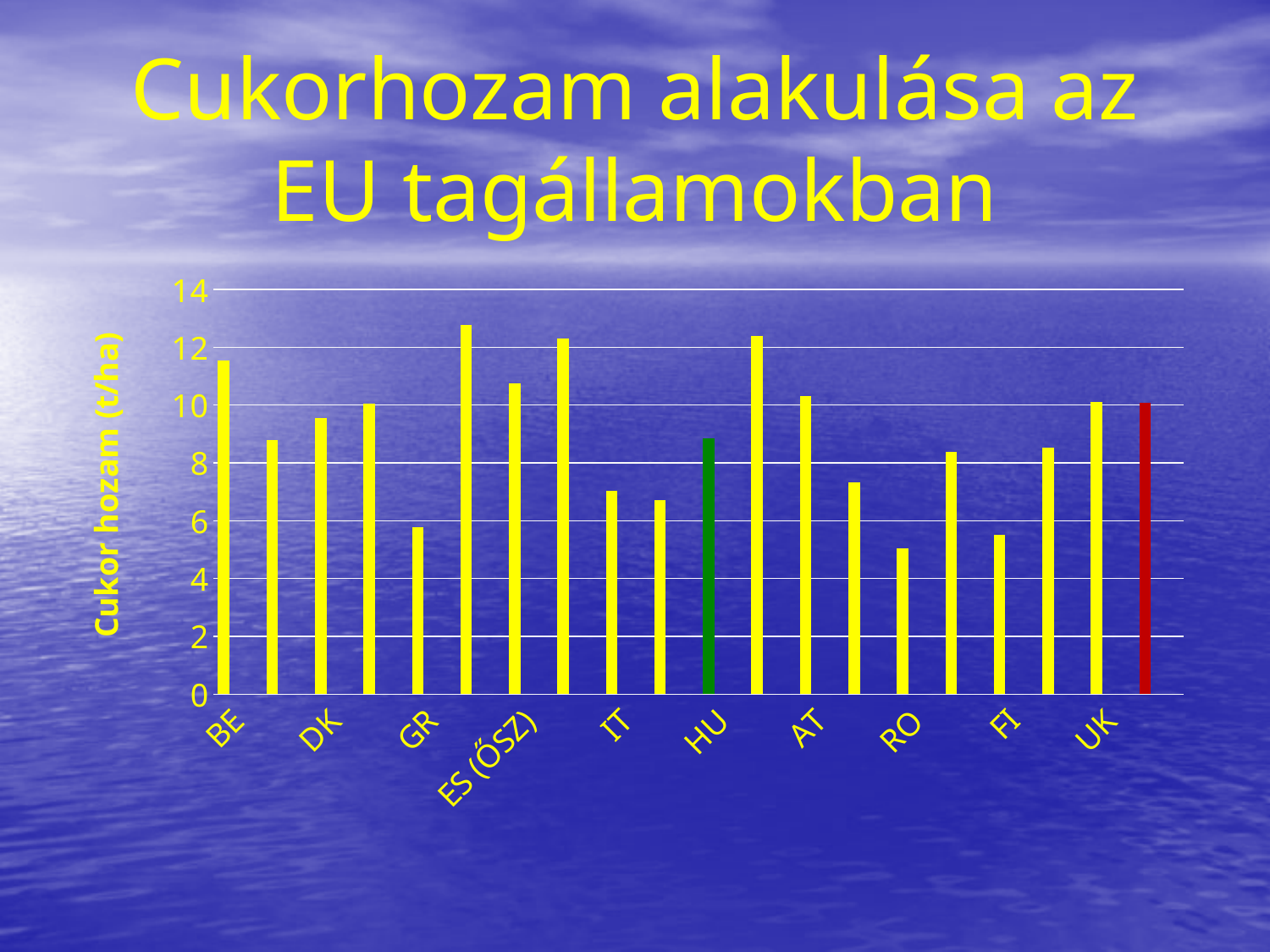
Is the value for BE greater or less than 10? greater Is the value for GR greater or less than 6? less Is the value for RO greater or less than 6? less What kind of chart is shown on the slide? bar chart Which has a higher value, BE or DK? BE Which has a higher value, GR or IT? IT How many bars are plotted in the chart? 20 What is the label of the vertical axis? Cukor hozam (t/ha) What is the title of the chart on the slide? Cukorhozam alakulása az EU tagállamokban